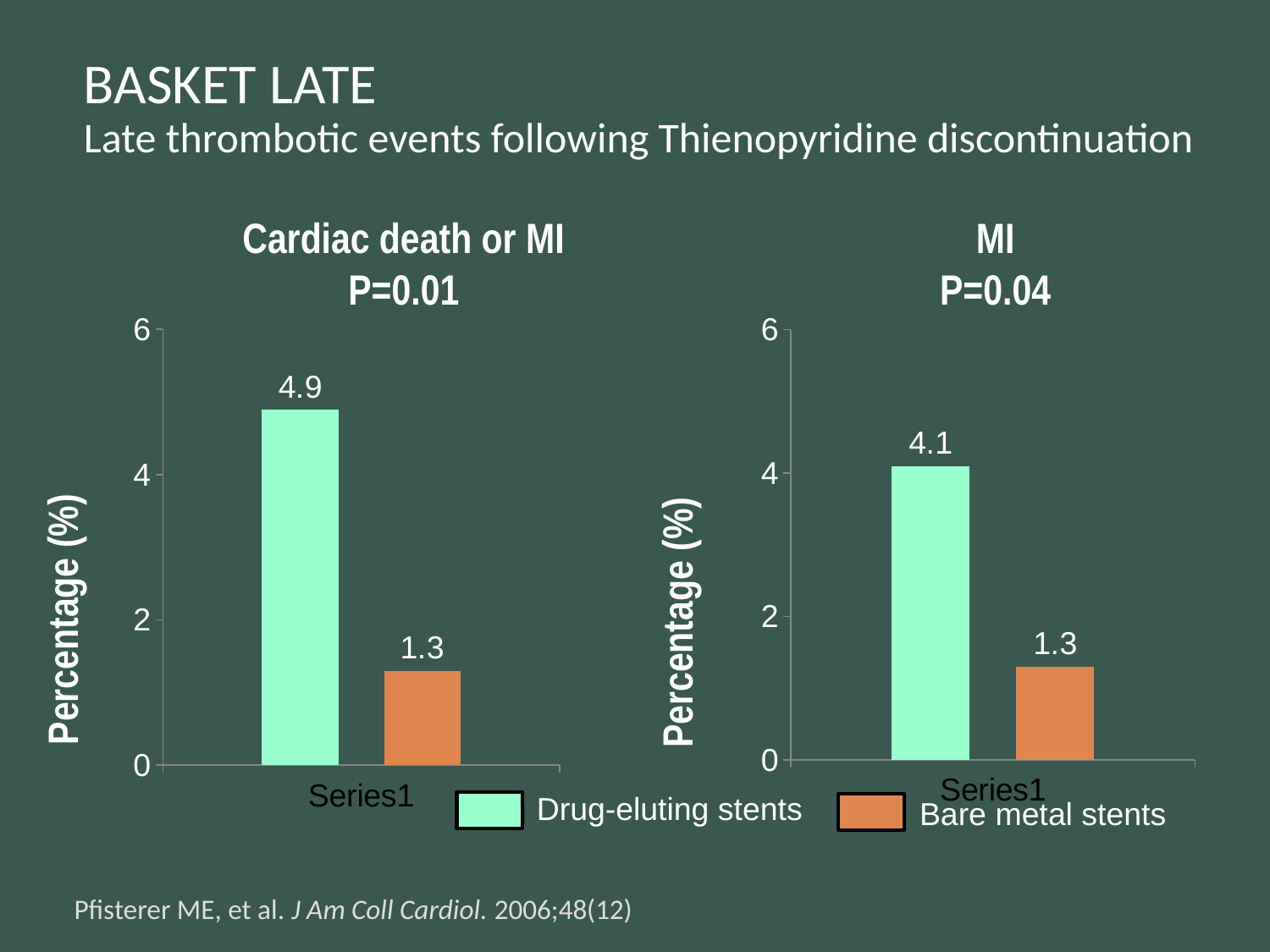
In the 'MI' chart, what is the value for Bare metal stents? 1.3 In the 'Cardiac death or MI' chart, what is the difference between the Drug-eluting stents and Bare metal stents values? 3.6 In the 'MI' chart, what is the difference between the Drug-eluting stents and Bare metal stents values? 2.8 What is the y-axis label on the 'Cardiac death or MI' chart? Percentage (%) In the 'Cardiac death or MI' chart, what is the value for Drug-eluting stents? 4.9 In the 'Cardiac death or MI' chart, which group has the lowest value? Bare metal stents In the 'Cardiac death or MI' chart, is the value for Drug-eluting stents greater or less than 4? greater In the 'MI' chart, which group has the higher value, Drug-eluting stents or Bare metal stents? Drug-eluting stents In the 'Cardiac death or MI' chart, what is the value for Bare metal stents? 1.3 In the 'MI' chart, what is the value for Drug-eluting stents? 4.1 What kind of chart is the 'MI' chart? Bar chart How many series does the legend list? 2